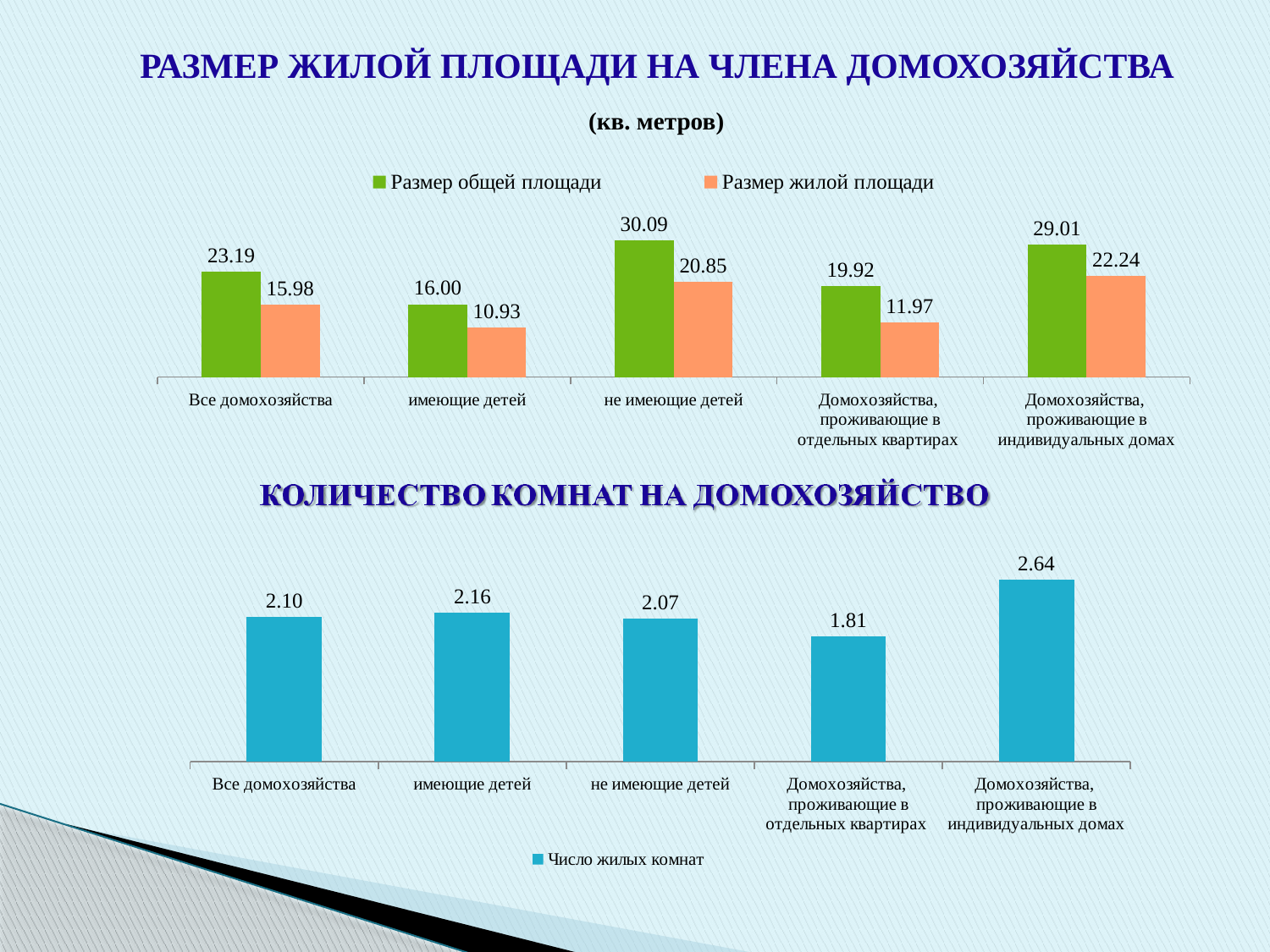
In the top chart (РАЗМЕР ЖИЛОЙ ПЛОЩАДИ НА ЧЛЕНА ДОМОХОЗЯЙСТВА), what is the value of Размер общей площади for Все домохозяйства? 23.19 In the top chart, which category has the lowest Размер жилой площади? имеющие детей How many categories are shown in the bottom chart? 5 In the bottom chart (КОЛИЧЕСТВО КОМНАТ НА ДОМОХОЗЯЙСТВО), what is the value for Домохозяйства, проживающие в индивидуальных домах? 2.64 How many series does the legend of the top chart list? 2 What type of chart is the bottom chart? Bar chart In the top chart, which is larger: Размер жилой площади for не имеющие детей or for Домохозяйства, проживающие в индивидуальных домах? Домохозяйства, проживающие в индивидуальных домах In the top chart, which category has the highest Размер общей площади? не имеющие детей In the bottom chart, which category has the lowest number of rooms? Домохозяйства, проживающие в отдельных квартирах In the top chart, what is the difference between Размер общей площади and Размер жилой площади for Домохозяйства, проживающие в отдельных квартирах? 7.95 In the top chart, what is the value of Размер жилой площади for имеющие детей? 10.93 In the bottom chart, what is the difference between the values for имеющие детей and не имеющие детей? 0.09